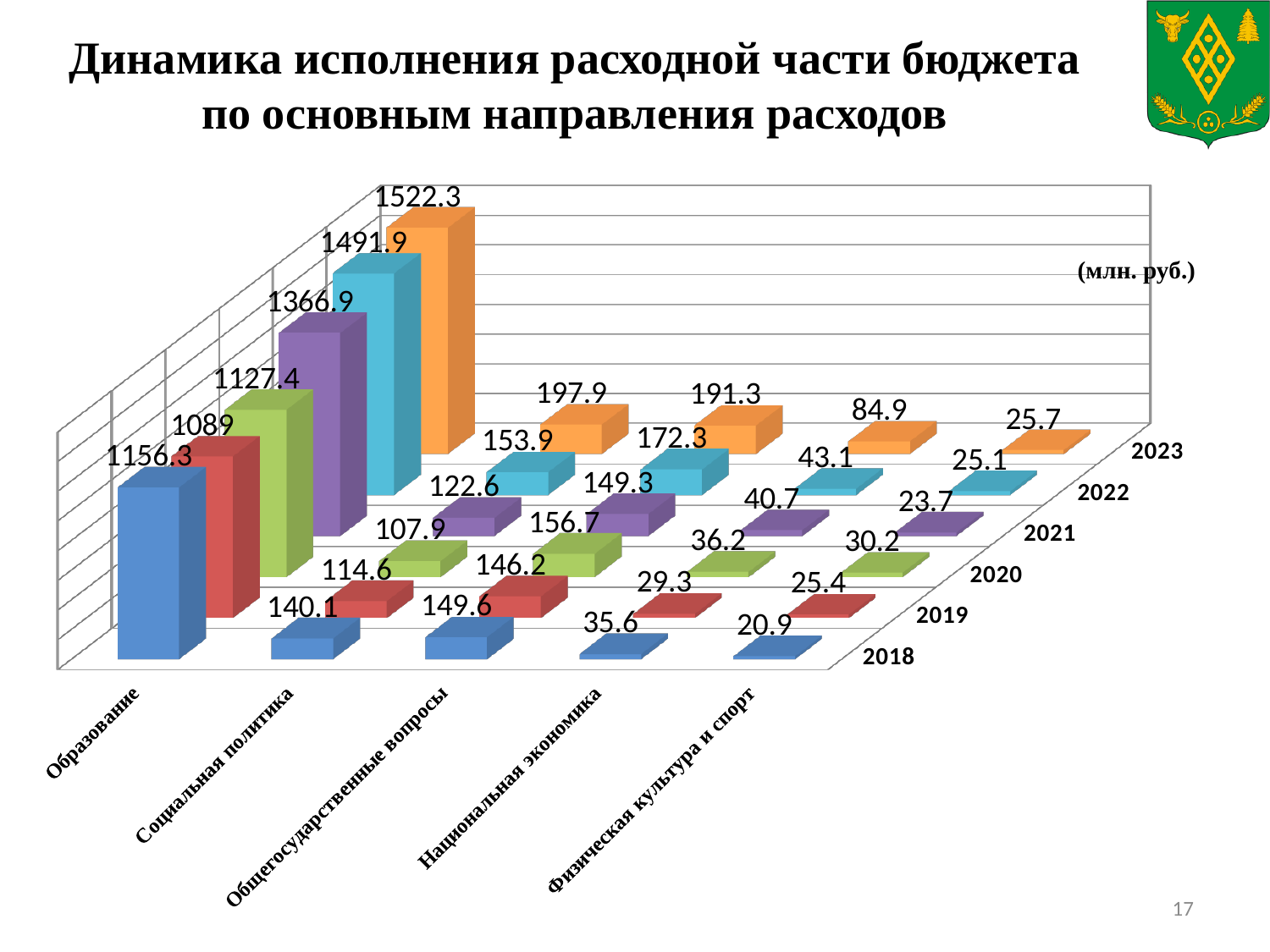
What is the value for Национальная экономика in 2023? 84.9 What is the value for Физическая культура и спорт in 2020? 30.2 What is the value for Социальная политика in 2018? 140.1 How many expenditure categories are shown along the horizontal axis? 5 What type of chart is shown on the slide? bar chart What unit is indicated on the chart? млн. руб. What is the value for Образование in 2023? 1522.3 Which year has the highest value for Образование? 2023 Which year has the lowest value for Физическая культура и спорт? 2018 How many years are shown on the depth axis of the chart? 6 What is the difference between the Образование values for 2023 and 2022? 30.4 Which is larger in 2023: Социальная политика or Общегосударственные вопросы? Социальная политика